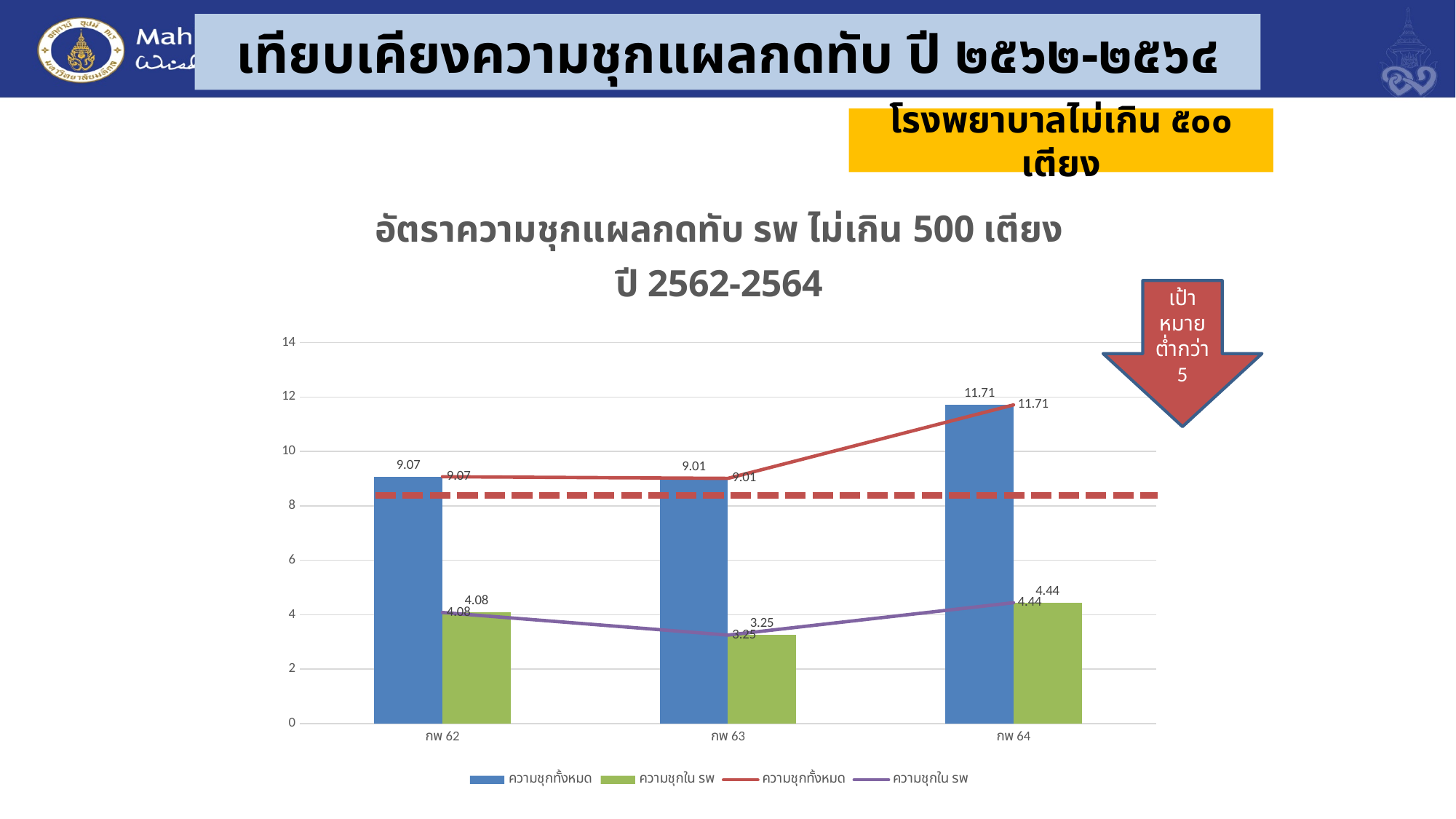
How many entries does the legend list? 4 What is the value of ความชุกใน รพ for กพ 63? 3.25 What is the value of ความชุกทั้งหมด for กพ 62? 9.07 Which category has the lowest value for ความชุกใน รพ? กพ 63 Which category has the highest value for ความชุกทั้งหมด? กพ 64 Which is larger, ความชุกใน รพ for กพ 62 or for กพ 64? กพ 64 Is the value of ความชุกทั้งหมด for กพ 64 greater or less than 10? greater What is the difference in ความชุกทั้งหมด between กพ 64 and กพ 63? 2.70 How many categories are shown on the x axis? 3 What is the value of ความชุกทั้งหมด for กพ 64? 11.71 What is the difference between ความชุกทั้งหมด and ความชุกใน รพ for กพ 64? 7.27 What kind of chart is shown on the slide? A combined bar and line chart